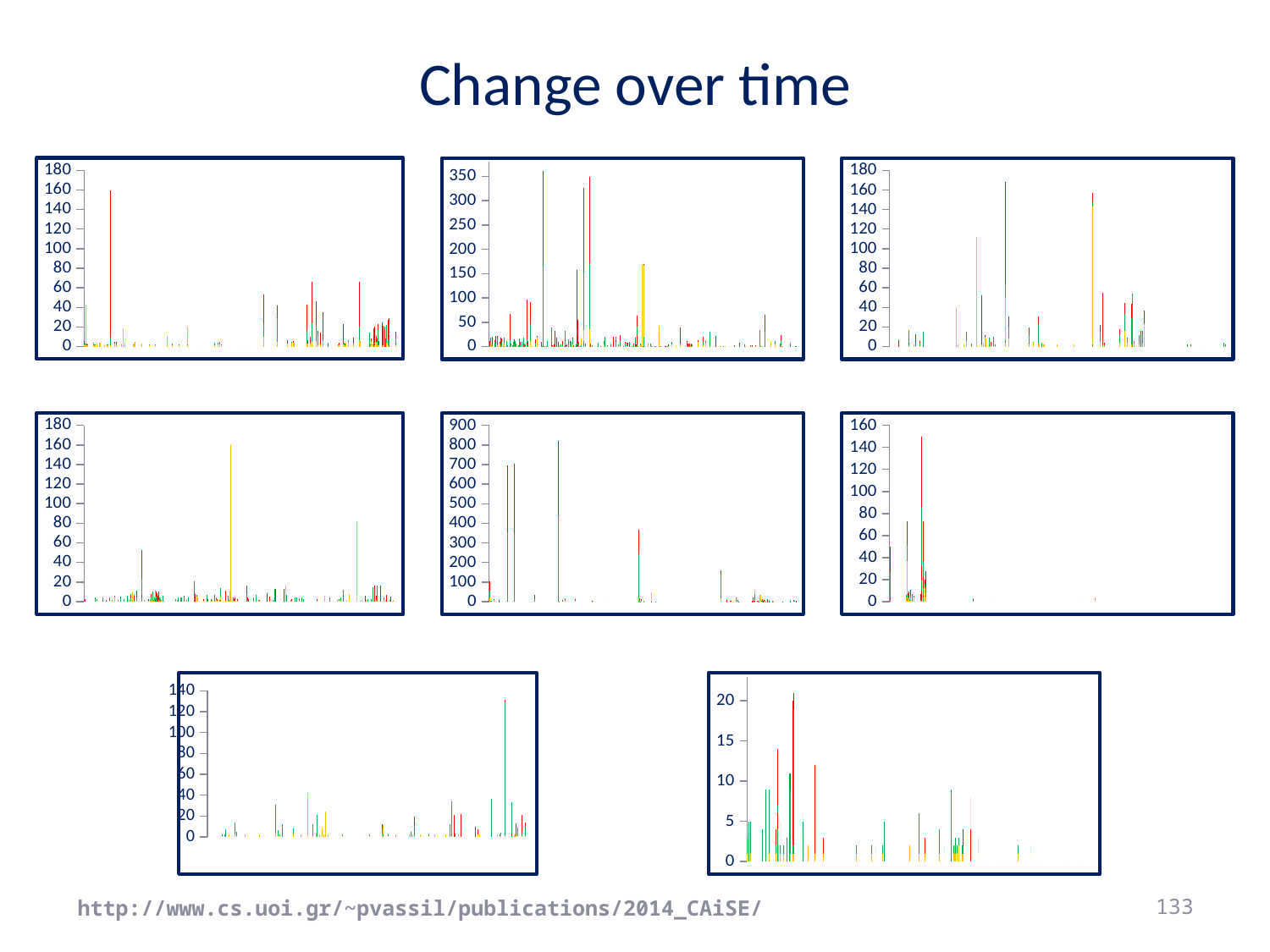
In the middle-right chart, is the value of the tallest bar greater or less than 120? greater In the top-middle chart, is the value of the tallest bar greater or less than 300? greater What is the title of the slide containing the charts? Change over time In the middle chart of the middle row, is the value of the tallest bar greater or less than 900? less What kind of chart is the top-left chart on the slide? bar chart How many charts are shown on the slide? 8